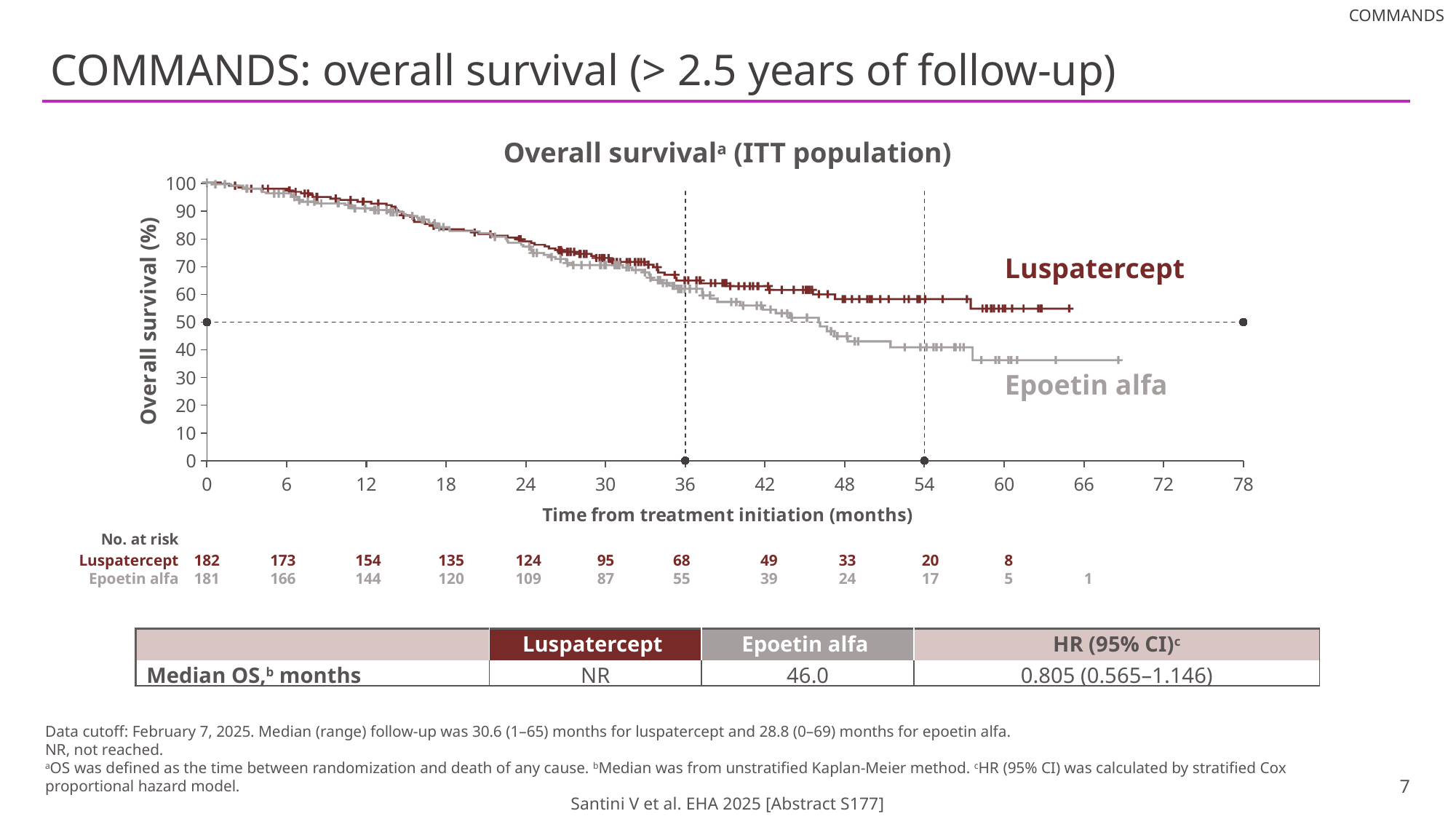
At 54 months, which curve is higher, Luspatercept or Epoetin alfa? Luspatercept What is the label of the x axis of the overall survival chart? Time from treatment initiation (months) What type of chart is shown under the title "Overall survival (ITT population)"? Line chart (Kaplan-Meier survival curve) What is the median OS in months for Epoetin alfa according to the table? 46.0 Is the overall survival for Luspatercept at 54 months greater or less than 50%? greater How many Luspatercept patients were at risk at 36 months? 68 Do the survival curves rise or fall as time from treatment initiation increases? Fall Is the overall survival for Epoetin alfa at 60 months greater or less than 40%? less How many Epoetin alfa patients were at risk at 0 months? 181 How many treatment groups are plotted on the overall survival chart? 2 Is the overall survival for Epoetin alfa at 54 months greater or less than 50%? less What is the difference between the number of Luspatercept and Epoetin alfa patients at risk at 0 months? 1